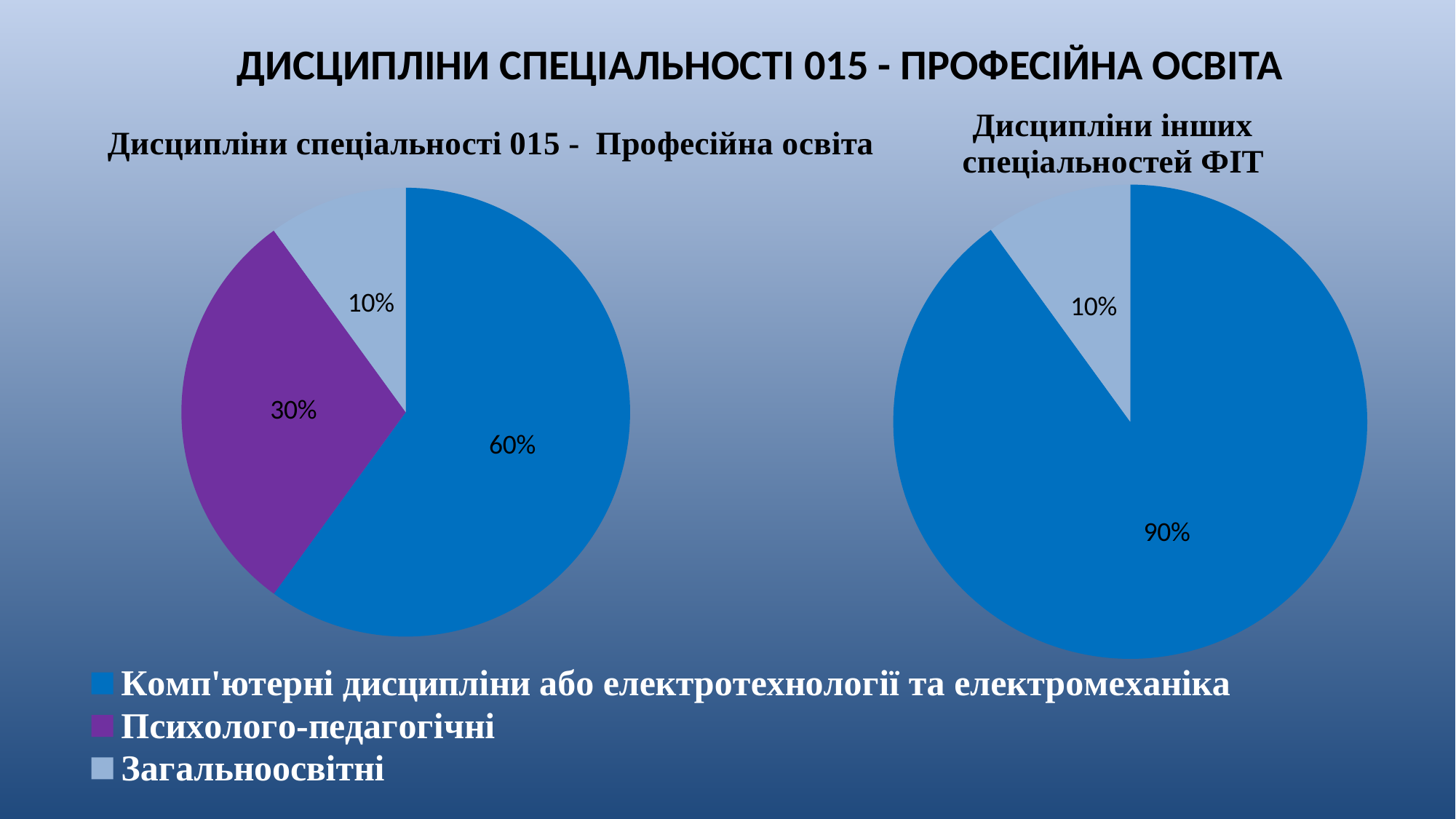
In the left chart "Дисципліни спеціальності 015 - Професійна освіта", which category has the largest slice? Комп'ютерні дисципліни або електротехнології та електромеханіка In the left chart "Дисципліни спеціальності 015 - Професійна освіта", what share is labelled for "Психолого-педагогічні"? 30% In the left chart "Дисципліни спеціальності 015 - Професійна освіта", what share is labelled for "Комп'ютерні дисципліни або електротехнології та електромеханіка"? 60% How many slices does the left chart "Дисципліни спеціальності 015 - Професійна освіта" have? 3 In the right chart "Дисципліни інших спеціальностей ФІТ", what share is labelled for "Загальноосвітні"? 10% In the left chart "Дисципліни спеціальності 015 - Професійна освіта", which category has the smallest slice? Загальноосвітні How many entries does the legend at the bottom of the slide list? 3 How many slices does the right chart "Дисципліни інших спеціальностей ФІТ" have? 2 What kind of chart is the left chart titled "Дисципліни спеціальності 015 - Професійна освіта"? pie chart In the left chart "Дисципліни спеціальності 015 - Професійна освіта", what share is labelled for "Загальноосвітні"? 10% In the right chart "Дисципліни інших спеціальностей ФІТ", what share is labelled for "Комп'ютерні дисципліни або електротехнології та електромеханіка"? 90% In the left chart "Дисципліни спеціальності 015 - Професійна освіта", what is the difference between the "Комп'ютерні дисципліни або електротехнології та електромеханіка" slice and the "Психолого-педагогічні" slice? 30%